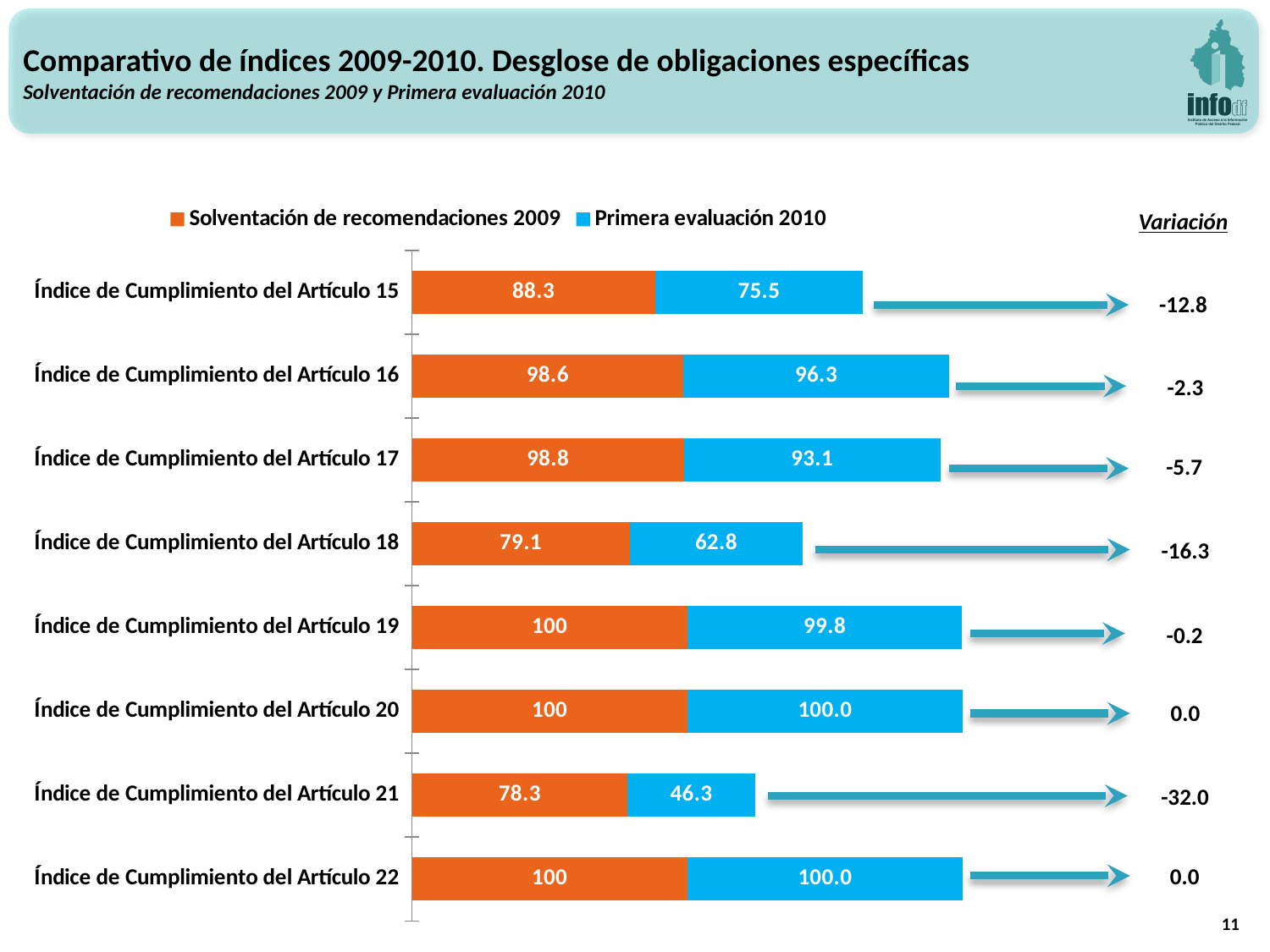
What is the Solventación de recomendaciones 2009 value for Índice de Cumplimiento del Artículo 15? 88.3 What is the Primera evaluación 2010 value for Índice de Cumplimiento del Artículo 21? 46.3 Which category has the lowest Primera evaluación 2010 value? Índice de Cumplimiento del Artículo 21 Which category has the lowest Solventación de recomendaciones 2009 value? Índice de Cumplimiento del Artículo 21 What is the difference between the 2009 and 2010 values for Índice de Cumplimiento del Artículo 15? 12.8 How many categories are shown in the chart? 8 How many series does the legend list? 2 Which is larger for Índice de Cumplimiento del Artículo 17: the Solventación de recomendaciones 2009 value or the Primera evaluación 2010 value? Solventación de recomendaciones 2009 What kind of chart is shown on the slide? Stacked bar chart What is the Variación shown for Índice de Cumplimiento del Artículo 21? -32.0 What is the Primera evaluación 2010 value for Índice de Cumplimiento del Artículo 18? 62.8 What is the total of the stacked bar for Índice de Cumplimiento del Artículo 21? 124.6